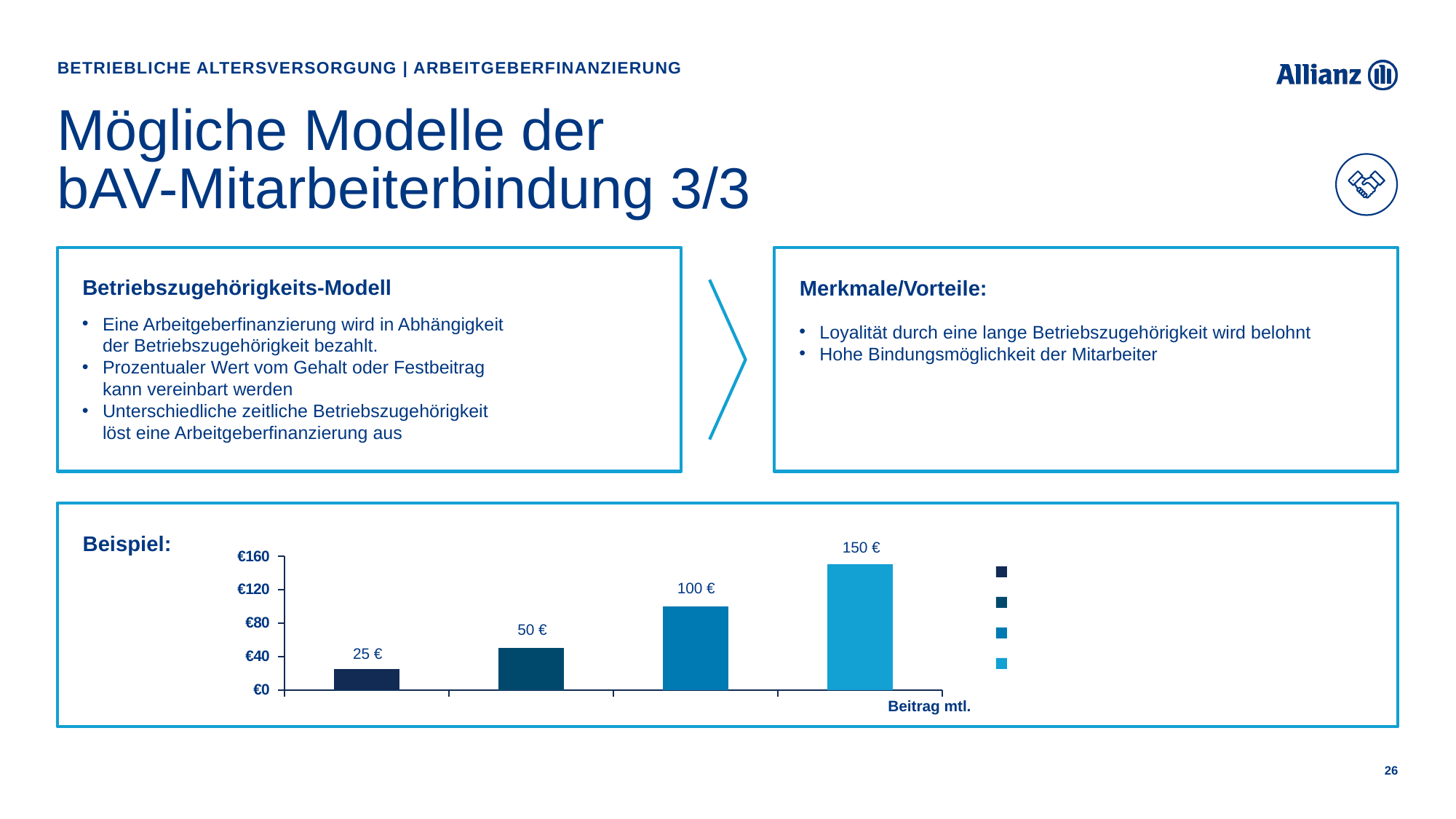
What type of chart is shown in the Beispiel section? bar chart Which bar has the lowest value in the chart? the leftmost bar (25 €) Which bar has the highest value in the chart? the rightmost bar (150 €) Which is larger, the second bar from the left or the third bar from the left? the third bar (100 €) What is the value of the leftmost bar in the chart? 25 € What is the label shown on the x axis of the chart? Beitrag mtl. Do the bar values rise or fall from left to right along the x axis? rise What is the value of the second bar from the left in the chart? 50 € What is the difference between the rightmost bar and the leftmost bar in the chart? 125 € What is the value of the rightmost bar in the chart? 150 € What is the value of the third bar from the left in the chart? 100 € How many bars are plotted in the chart? 4